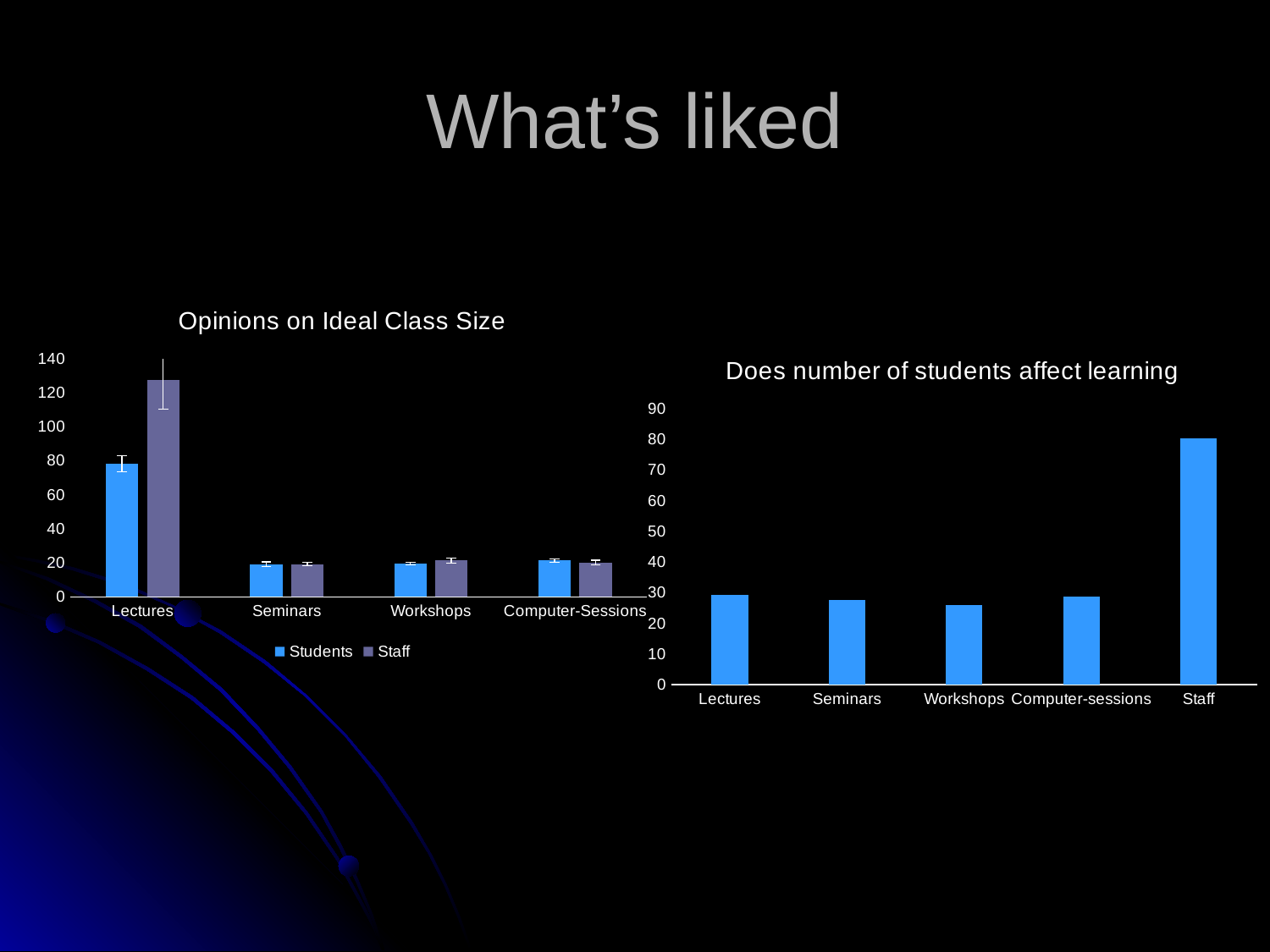
In the chart titled "Opinions on Ideal Class Size", what kind of chart is shown? bar chart In the chart titled "Opinions on Ideal Class Size", is the Students value for Lectures greater or less than 100? less In the chart titled "Opinions on Ideal Class Size", how many categories are shown on the x axis? 4 In the chart titled "Opinions on Ideal Class Size", for Lectures, which is larger: the Students value or the Staff value? Staff In the chart titled "Does number of students affect learning", is the value for Staff greater or less than 60? greater In the chart titled "Opinions on Ideal Class Size", what are the two legend entries? Students and Staff In the chart titled "Does number of students affect learning", how many categories are shown on the x axis? 5 In the chart titled "Does number of students affect learning", is the value for Workshops greater or less than 30? less In the chart titled "Opinions on Ideal Class Size", how many series does the legend list? 2 In the chart titled "Opinions on Ideal Class Size", which category has the highest Staff value? Lectures In the chart titled "Does number of students affect learning", which category has the highest value? Staff